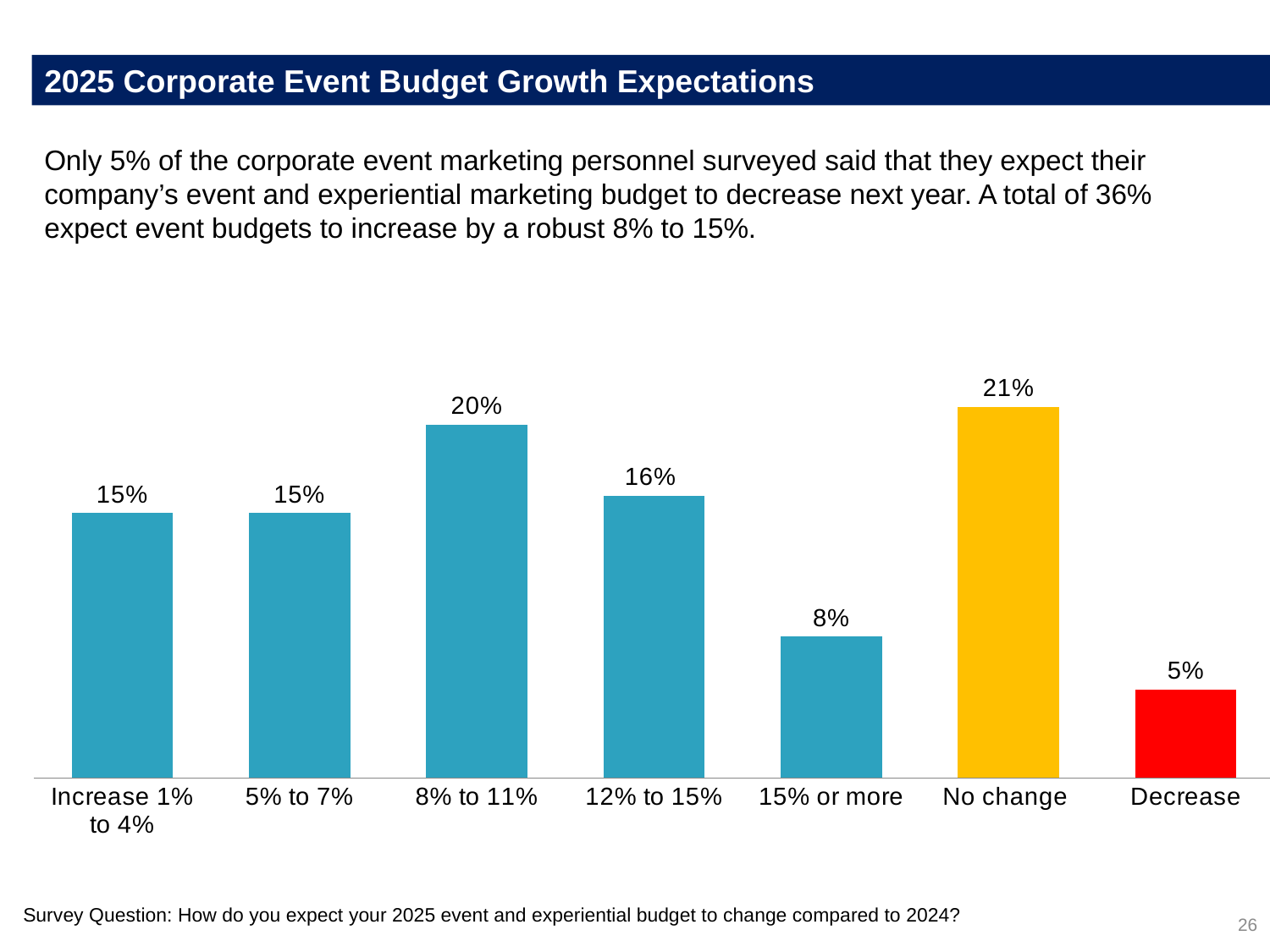
Which category has the highest percentage of respondents? No change What percentage of respondents expect their budget to decrease? 5% Which is larger: the value for '8% to 11%' or the value for '12% to 15%'? 8% to 11% Which category has the lowest percentage of respondents? Decrease What is the difference in percentage points between the 'No change' bar and the 'Decrease' bar? 16 What percentage of respondents expect an increase of 15% or more? 8% What is the combined percentage of the '8% to 11%' and '12% to 15%' categories? 36% How many categories are shown on the x axis of the chart? 7 What kind of chart is shown on the slide? Bar chart What colour is the 'Decrease' bar? Red What percentage of respondents expect no change in their 2025 event budget? 21% What percentage of respondents expect their budget to increase by 8% to 11%? 20%